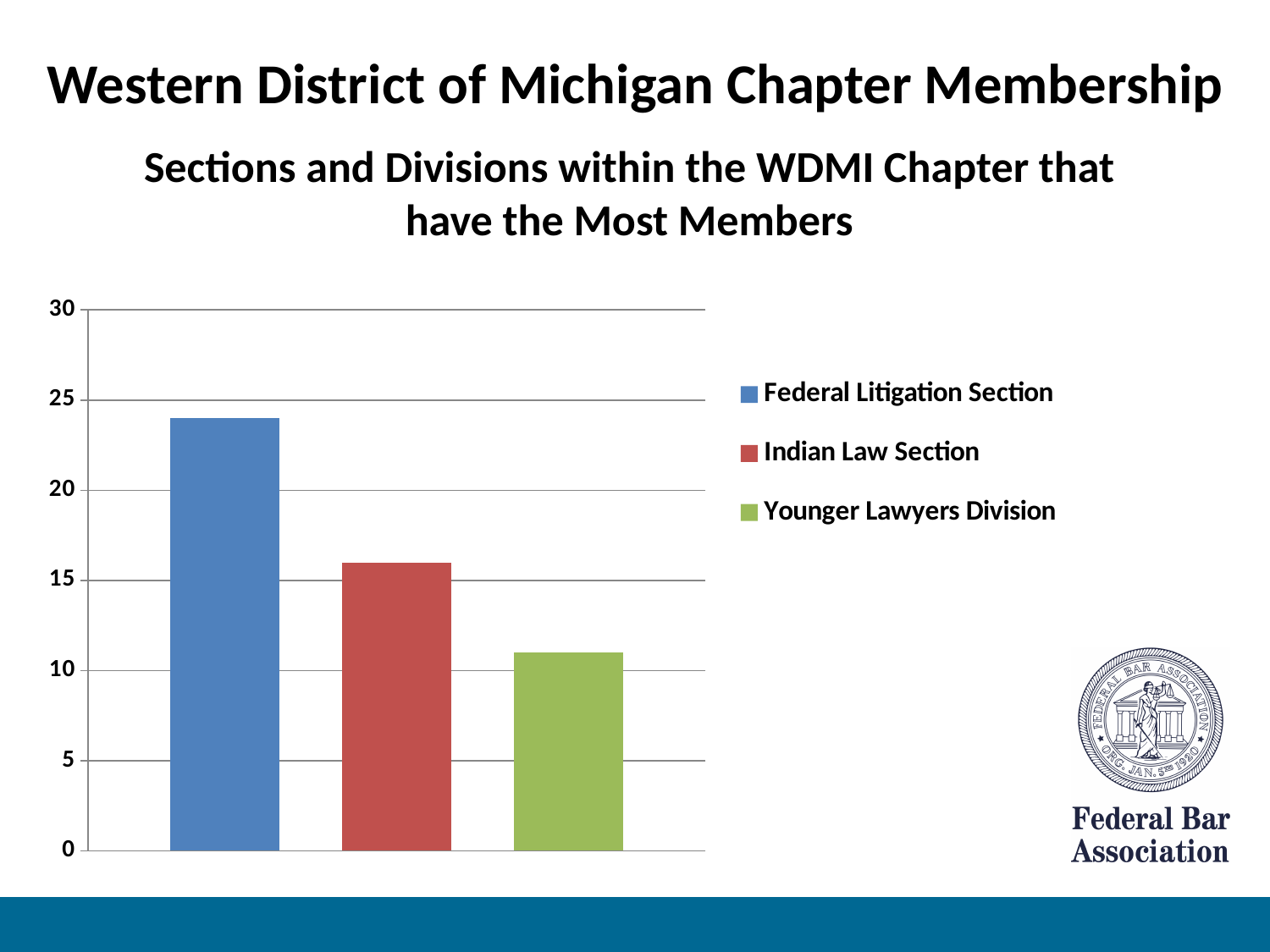
Which section or division has the lowest number of members? Younger Lawyers Division Which has more members, the Federal Litigation Section or the Indian Law Section? Federal Litigation Section How many bars are plotted in the chart? 3 Is the value for the Indian Law Section greater or less than 20? less Which has more members, the Indian Law Section or the Younger Lawyers Division? Indian Law Section What kind of chart is shown on the slide? bar chart How many series does the legend list? 3 What is the title of the chart? Sections and Divisions within the WDMI Chapter that have the Most Members Which section or division has the highest number of members? Federal Litigation Section Is the value for the Federal Litigation Section greater or less than 20? greater Is the value for the Younger Lawyers Division greater or less than 10? greater What colour is the bar for the Indian Law Section? red